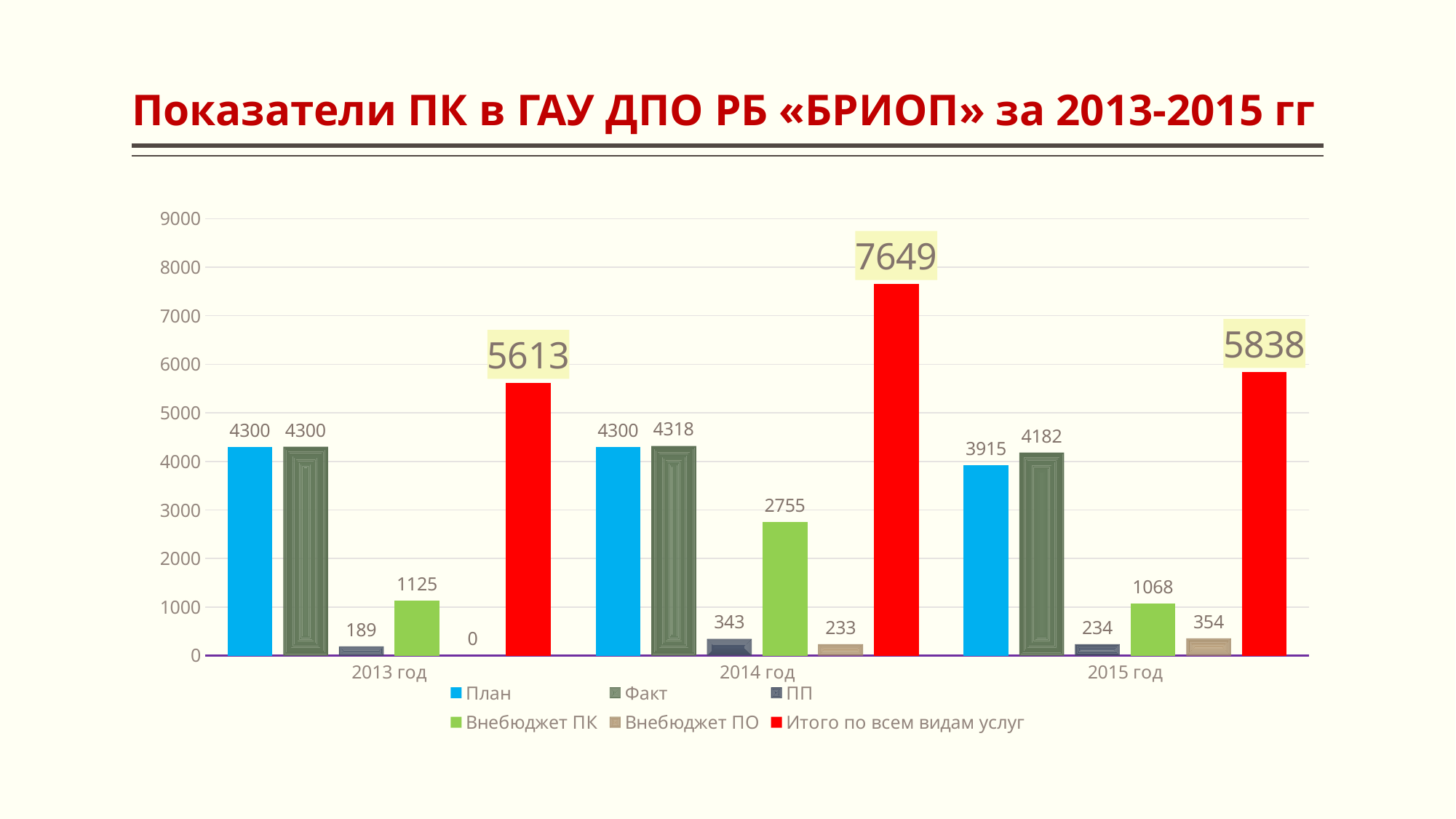
What kind of chart is shown on the slide? bar chart What is the value of Внебюджет ПО for 2013 год? 0 What is the value of Итого по всем видам услуг for 2014 год? 7649 In which year is Итого по всем видам услуг highest? 2014 год Which is larger for 2014 год: ПП or Внебюджет ПО? ПП Is the value of Итого по всем видам услуг for 2013 год greater or less than 5000? greater What is the difference between Факт and План for 2015 год? 267 What is the title of the chart? Показатели ПК в ГАУ ДПО РБ «БРИОП» за 2013-2015 гг What is the value of Внебюджет ПК for 2013 год? 1125 How many series does the legend list? 6 In which year is Внебюджет ПК lowest? 2015 год What is the value of План for 2015 год? 3915